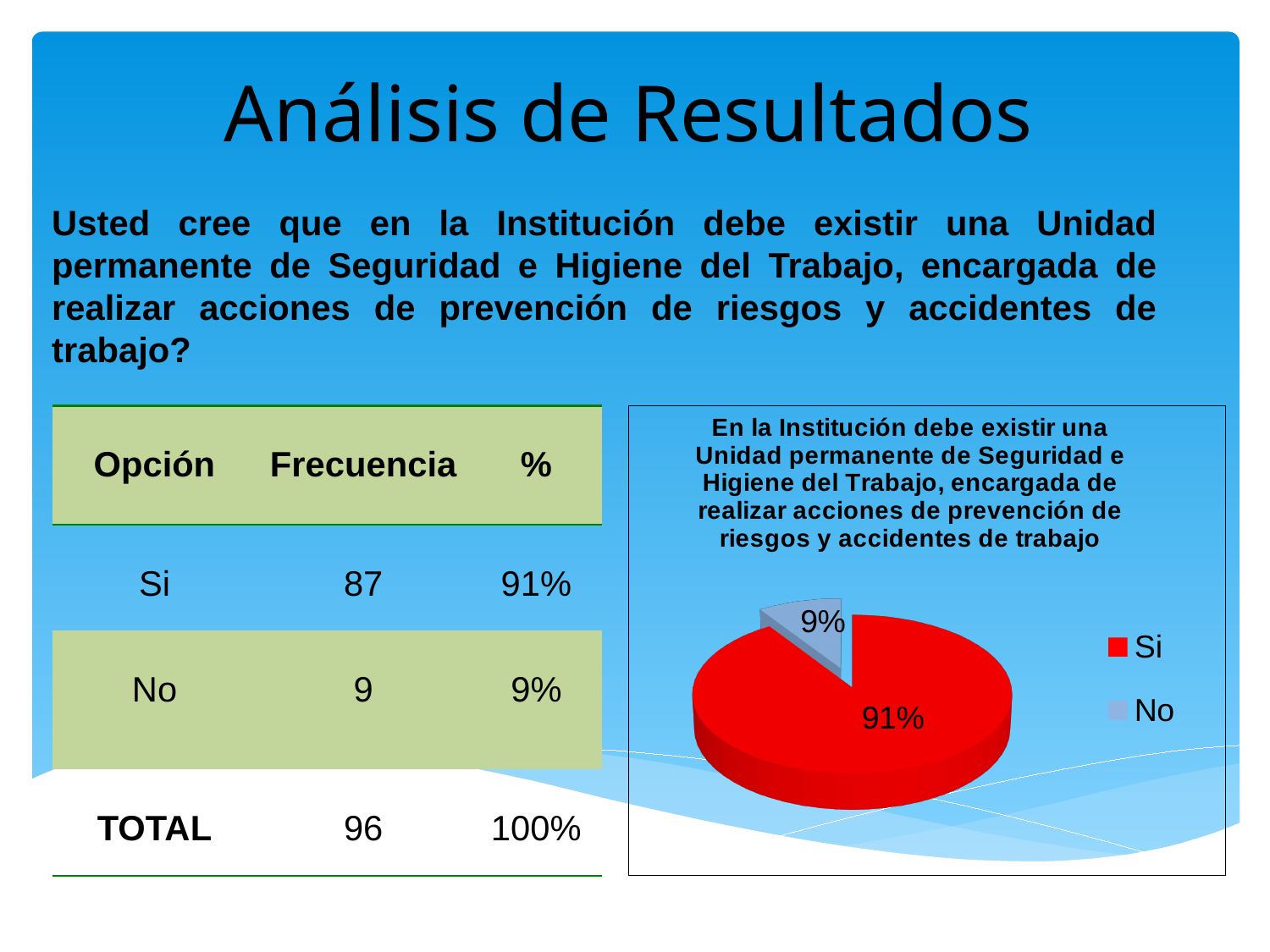
What is the difference in percentage points between the 'Si' and 'No' slices? 82 What share of the pie does the 'No' slice represent? 9% What kind of chart is shown on the slide? pie chart What percentage does the 'No' slice show in the pie chart? 9% What colour is the 'Si' slice in the pie chart? red Which slice of the pie chart is the largest? Si How many entries does the legend of the pie chart list? 2 Which slice of the pie chart is the smallest? No Which is larger in the pie chart, 'Si' or 'No'? Si Which legend entry is listed first in the pie chart's legend? Si What percentage does the 'Si' slice show in the pie chart? 91% How many slices does the pie chart have? 2